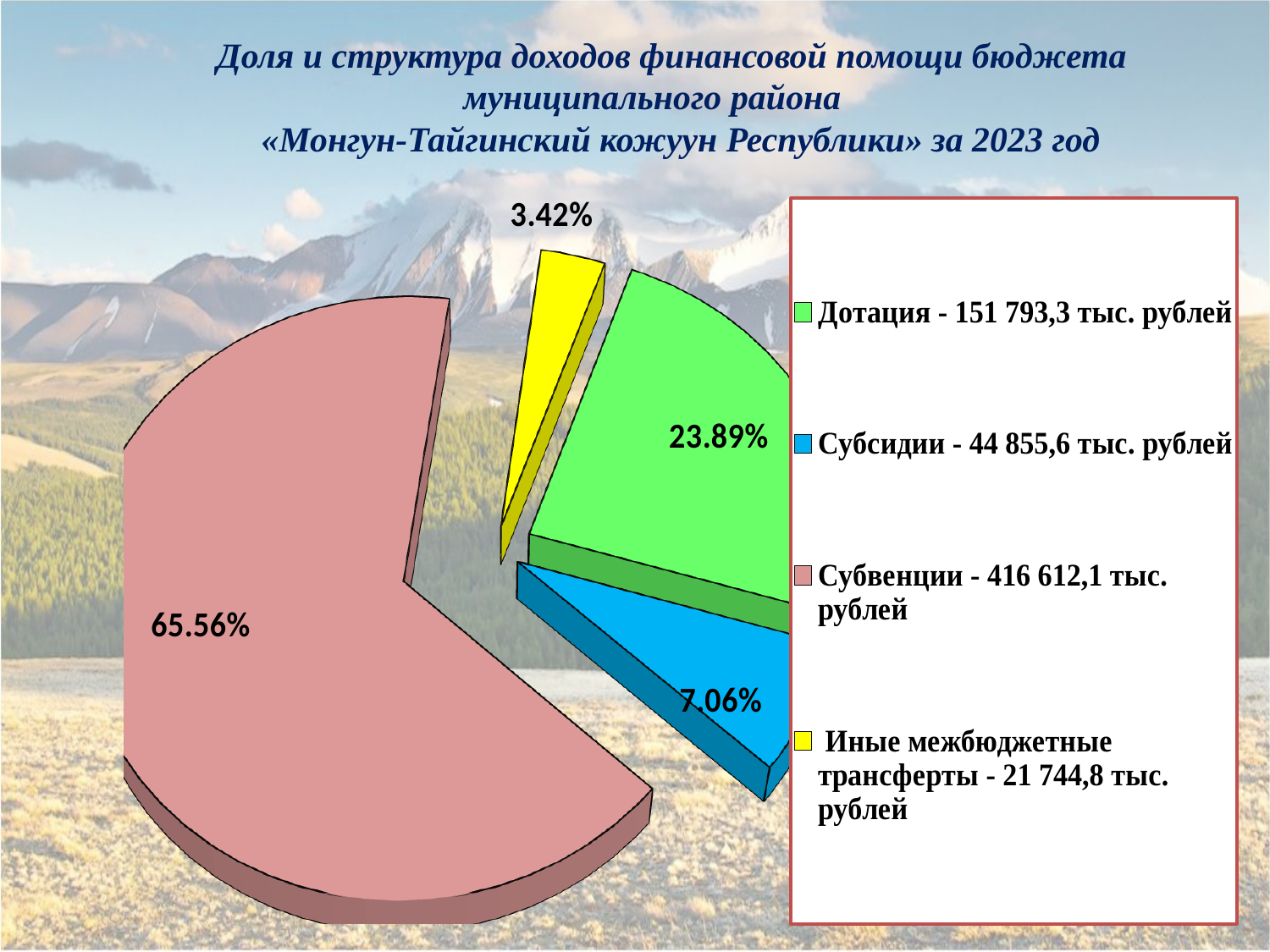
What share of the pie does Субвенции represent? 65.56% What is the amount shown in the legend for Дотация? 151 793,3 тыс. рублей How many slices does the pie chart have? 4 What share of the pie does Субсидии represent? 7.06% What type of chart is shown on the slide? pie chart Which category has the largest slice of the pie? Субвенции What is the difference in percentage points between the Субвенции slice and the Дотация slice? 41.67 Which colour represents Субсидии in the pie chart? blue What share of the pie does Дотация represent? 23.89% Which category has the smallest slice of the pie? Иные межбюджетные трансферты How many entries does the legend list? 4